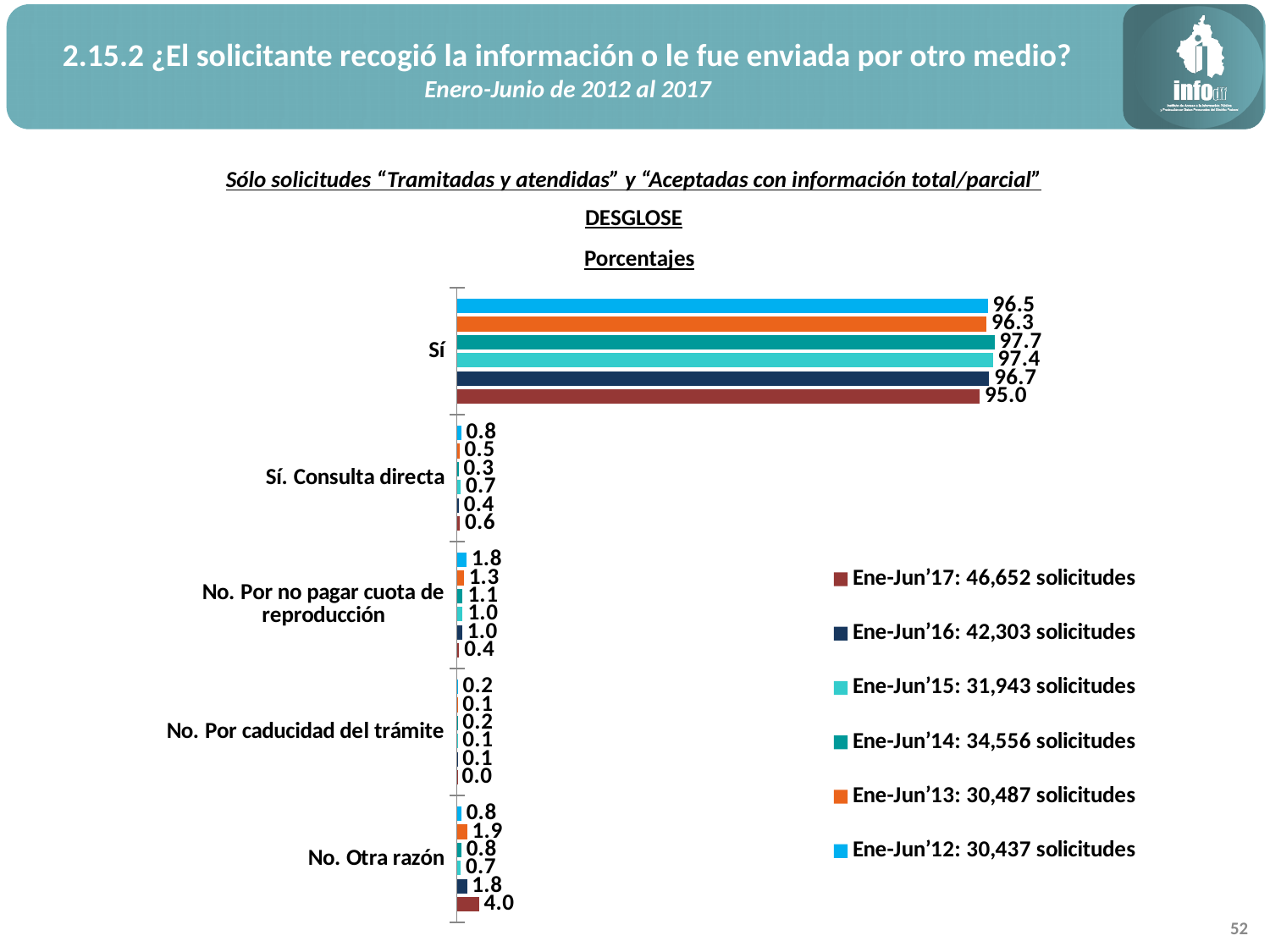
According to the legend, how many solicitudes does the Ene-Jun'17 series represent? 46,652 solicitudes What is the value for "Sí" in the Ene-Jun'17 series? 95.0 How many categories are plotted on the chart? 5 What is the value for "No. Otra razón" in the Ene-Jun'17 series? 4.0 Which series has the highest value for "Sí"? Ene-Jun'14 What kind of chart is shown on the slide? bar chart What is the value for "Sí" in the Ene-Jun'14 series? 97.7 Which series has the lowest value for "No. Otra razón"? Ene-Jun'15 What is the difference between the Ene-Jun'14 and Ene-Jun'17 values for "Sí"? 2.7 What is the value for "No. Por no pagar cuota de reproducción" in the Ene-Jun'12 series? 1.8 For "No. Otra razón", which is larger: the Ene-Jun'13 value or the Ene-Jun'16 value? Ene-Jun'13 How many series does the legend list? 6